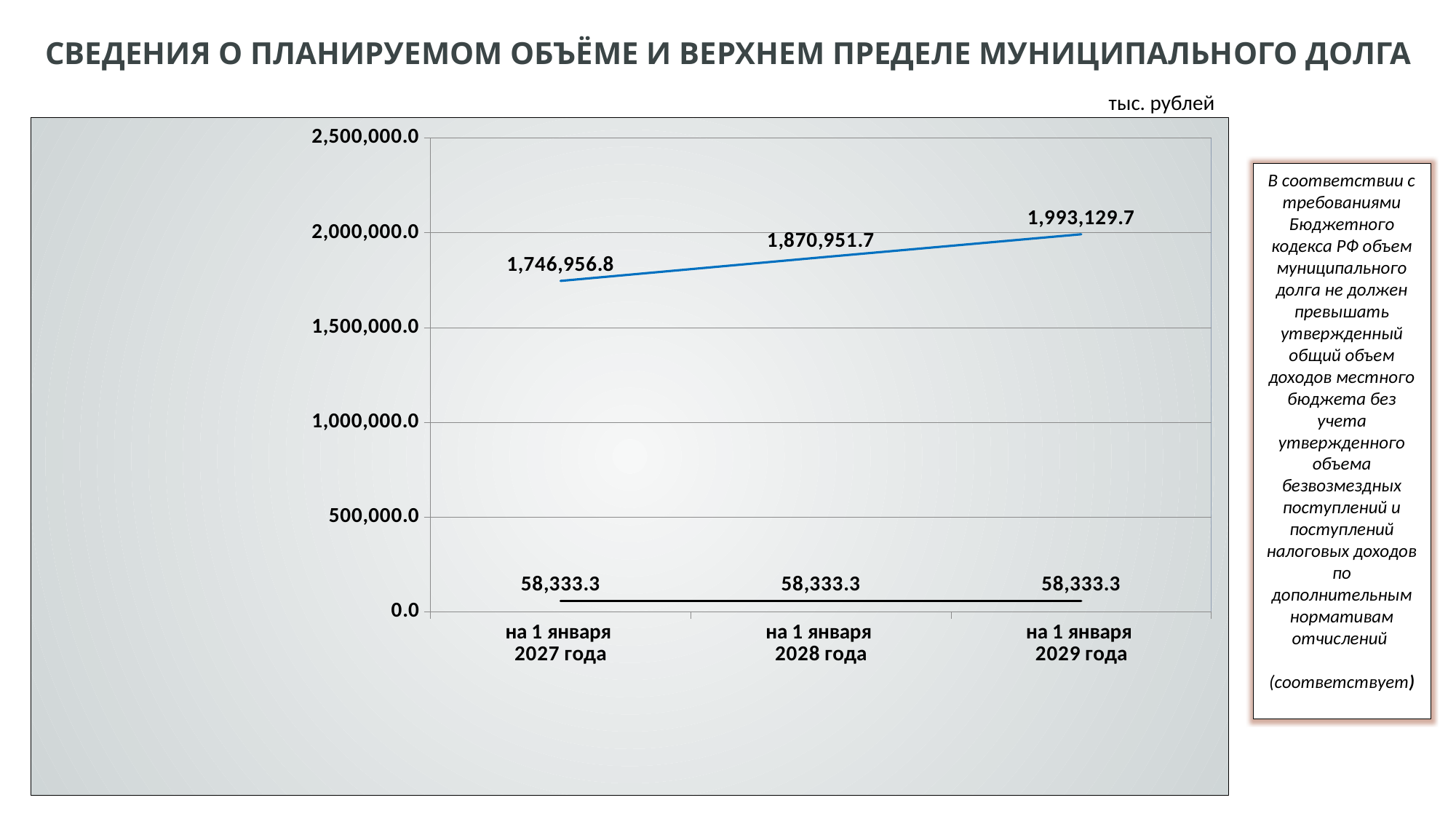
What is the value of the black line on 1 January 2028 (на 1 января 2028 года)? 58,333.3 At which date does the blue line reach its highest value? на 1 января 2029 года By how much does the blue line's value on 1 January 2029 exceed its value on 1 January 2027? 246,172.9 Does the blue line rise or fall from 1 January 2027 to 1 January 2029? rises How many dates are shown on the x axis of the chart? 3 At which date does the blue line have its lowest value? на 1 января 2027 года What is the difference between the blue line's values on 1 January 2028 and 1 January 2027? 123,994.9 What is the value of the blue line on 1 January 2028 (на 1 января 2028 года)? 1,870,951.7 Is the blue line's value on 1 January 2028 greater or less than 2,000,000.0? less What is the value of the blue line on 1 January 2027 (на 1 января 2027 года)? 1,746,956.8 What is the value of the blue line on 1 January 2029 (на 1 января 2029 года)? 1,993,129.7 Which is larger on 1 January 2029: the blue line value or the black line value? the blue line value